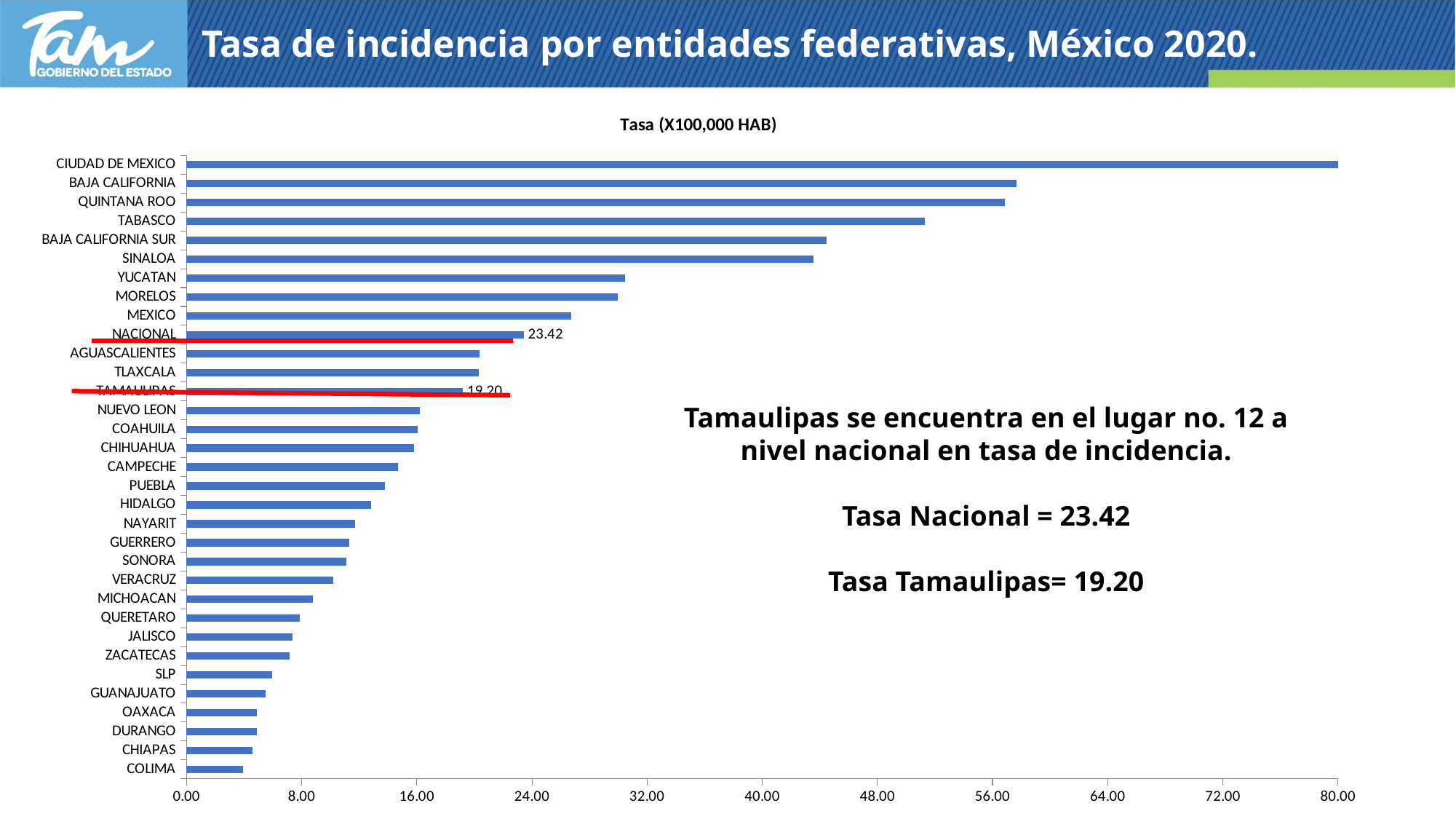
Which category has the highest value? CIUDAD DE MEXICO Is the value for COLIMA greater or less than 8.00? less Which is larger, the value for TABASCO or the value for SINALOA? TABASCO What is the value for TAMAULIPAS? 19.20 Is the value for CIUDAD DE MEXICO greater or less than 72.00? greater What is the title of the chart? Tasa (X100,000 HAB) How many categories are plotted in the chart? 33 What is the value for NACIONAL? 23.42 Which is larger, the value for VERACRUZ or the value for MICHOACAN? VERACRUZ What type of chart is shown on the slide? bar chart Is the value for SINALOA greater or less than 48.00? less What is the difference between the NACIONAL value and the TAMAULIPAS value? 4.22